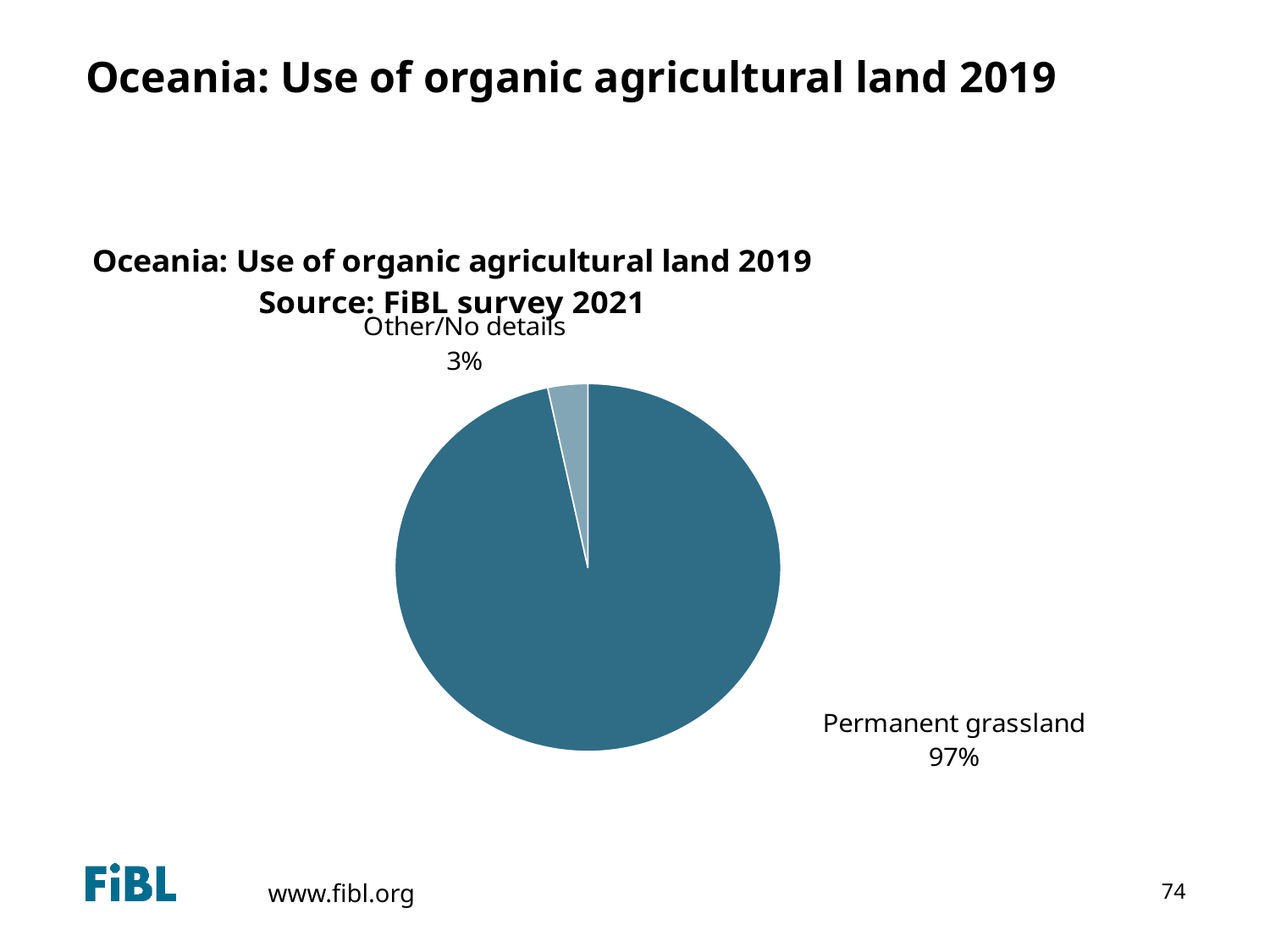
What is the title of the chart? Oceania: Use of organic agricultural land 2019 What kind of chart is shown on the slide? Pie chart How many slices does the pie chart have? 2 Which category has the largest share of the pie? Permanent grassland Which category has the smallest share of the pie? Other/No details What source is given for the chart data? FiBL survey 2021 What share of the pie is labelled Other/No details? 3% Which is larger: the share for Permanent grassland or the share for Other/No details? Permanent grassland What share of organic agricultural land in Oceania is permanent grassland? 97% What is the difference in percentage points between the Permanent grassland share and the Other/No details share? 94 percentage points